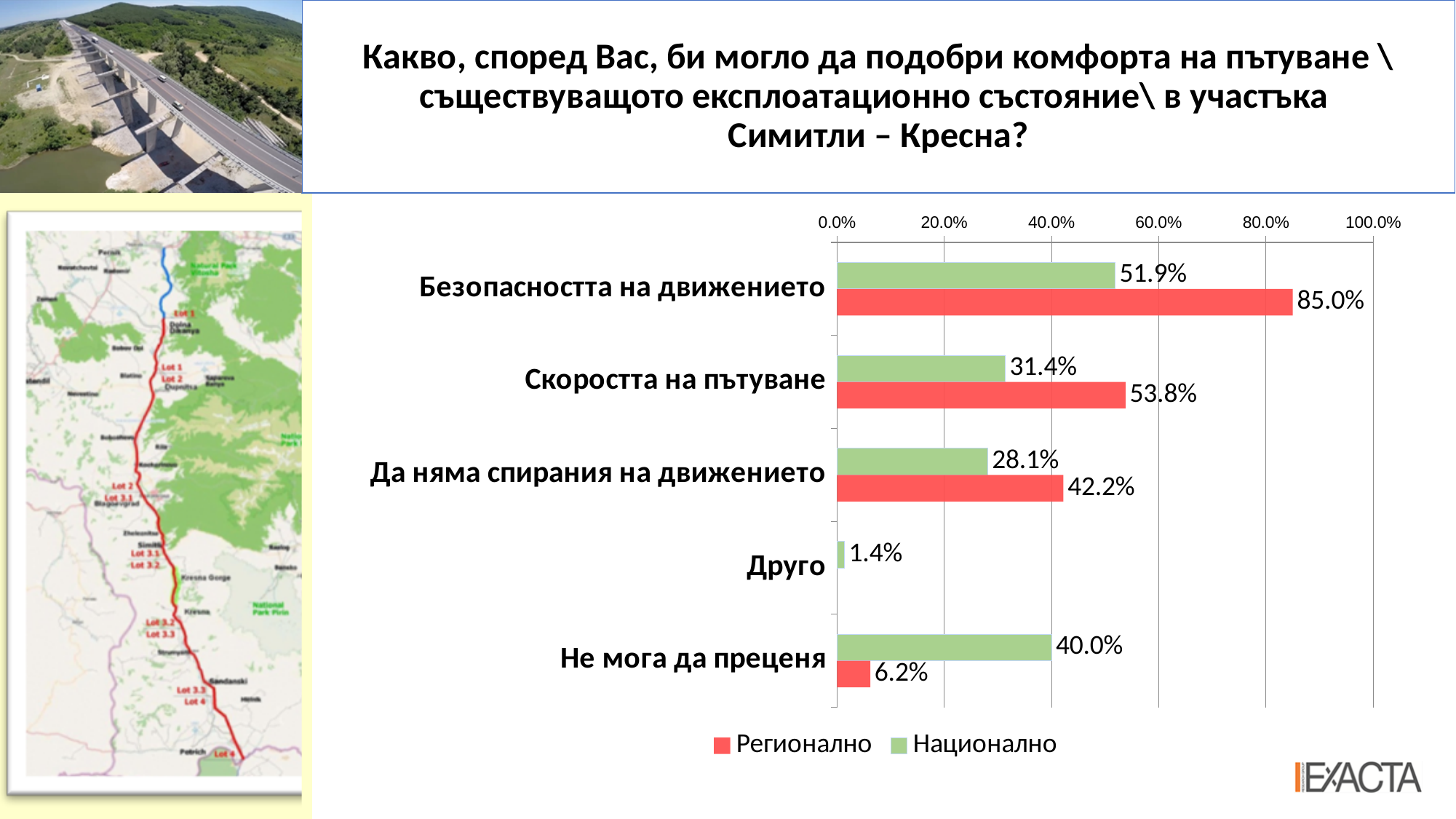
For Не мога да преценя, which series has the larger value, Регионално or Национално? Национално What is the difference between the Регионално and Национално values for Безопасността на движението? 33.1% What kind of chart is shown on the slide? Bar chart How many series does the legend list? 2 How many categories are shown on the chart? 5 Which category has the highest Регионално value? Безопасността на движението What is the Регионално value for Не мога да преценя? 6.2% What is the Национално value for Друго? 1.4% What is the Национално value for Скоростта на пътуване? 31.4% Which colour represents the Регионално series? Red Which category has the lowest Национално value? Друго What is the Регионално value for Безопасността на движението? 85.0%